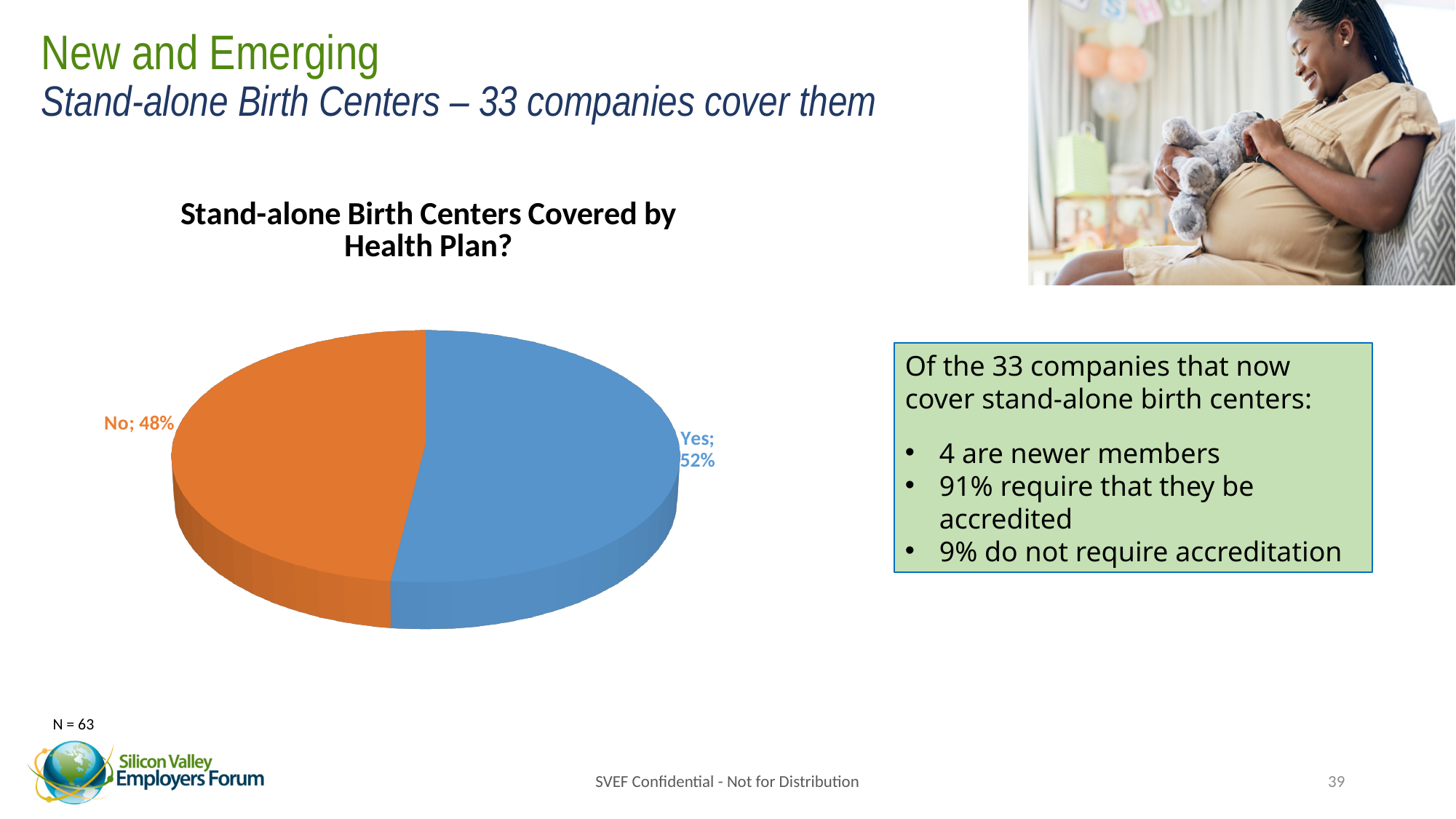
What is the sample size (N) noted below the chart? N = 63 How many slices does the pie chart have? 2 What is the difference in percentage points between the Yes and No slices? 4 Which slice of the pie chart is the smallest? No What is the title of the chart? Stand-alone Birth Centers Covered by Health Plan? What percentage of companies answered Yes to covering stand-alone birth centers? 52% What colour is the Yes slice of the pie chart? Blue What kind of chart is shown on the slide? Pie chart Which is larger, the Yes slice or the No slice? Yes Which slice of the pie chart is the largest? Yes What percentage of companies answered No to covering stand-alone birth centers? 48%